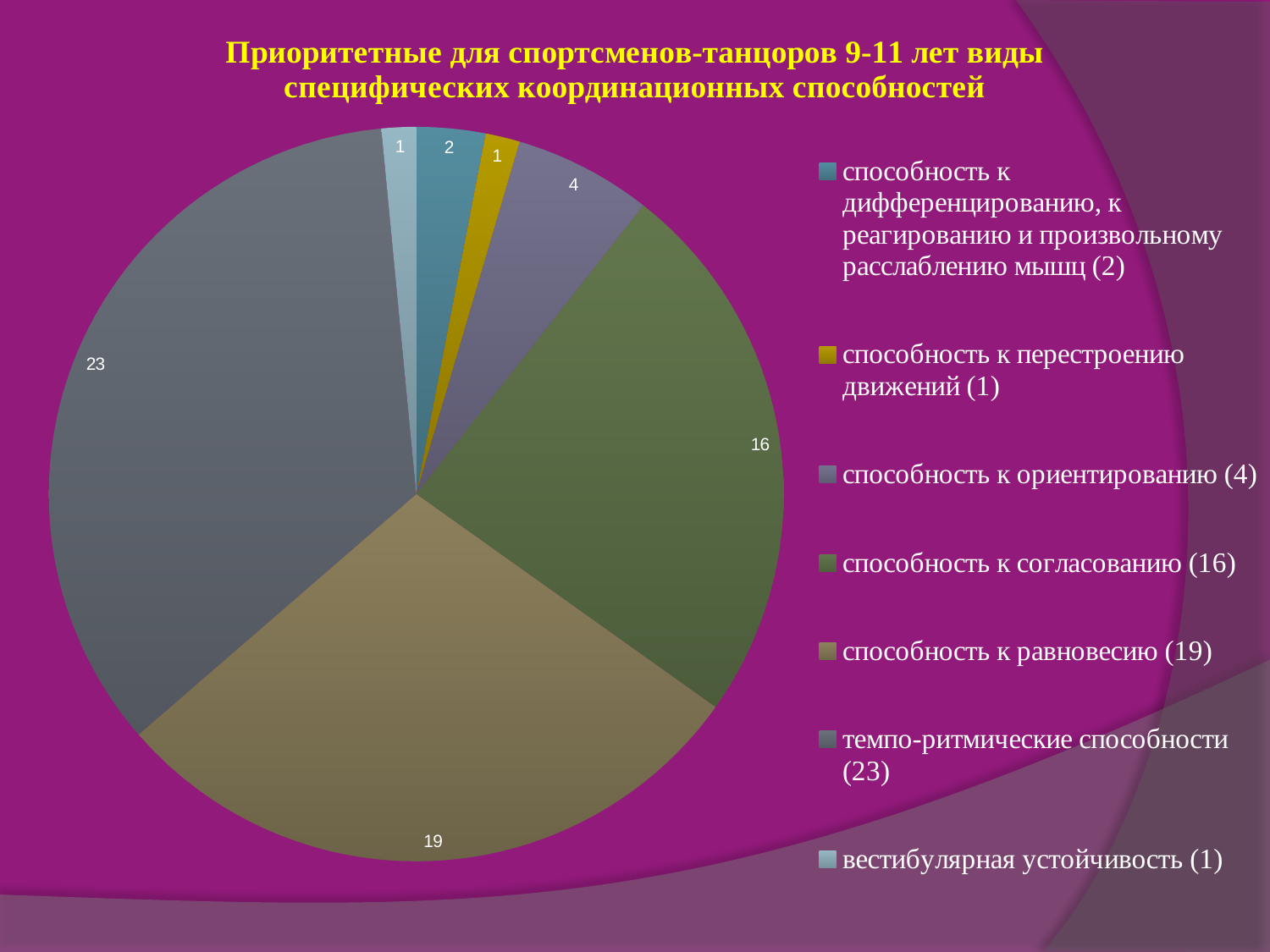
What value is shown for the slice 'способность к согласованию'? 16 What value is shown for the slice 'способность к равновесию'? 19 What is the sum of all the values shown on the pie chart? 66 Which is larger: the slice for 'способность к согласованию' or the slice for 'способность к равновесию'? способность к равновесию Which category has the largest slice of the pie? темпо-ритмические способности What value is shown for the slice 'темпо-ритмические способности'? 23 What value is shown for the slice 'способность к ориентированию'? 4 What is the difference between the values for 'способность к равновесию' and 'способность к согласованию'? 3 What is the smallest value shown on any slice of the pie? 1 What is the difference between the values for 'темпо-ритмические способности' and 'способность к равновесию'? 4 What type of chart is shown on the slide? Pie chart How many slices does the pie chart have? 7